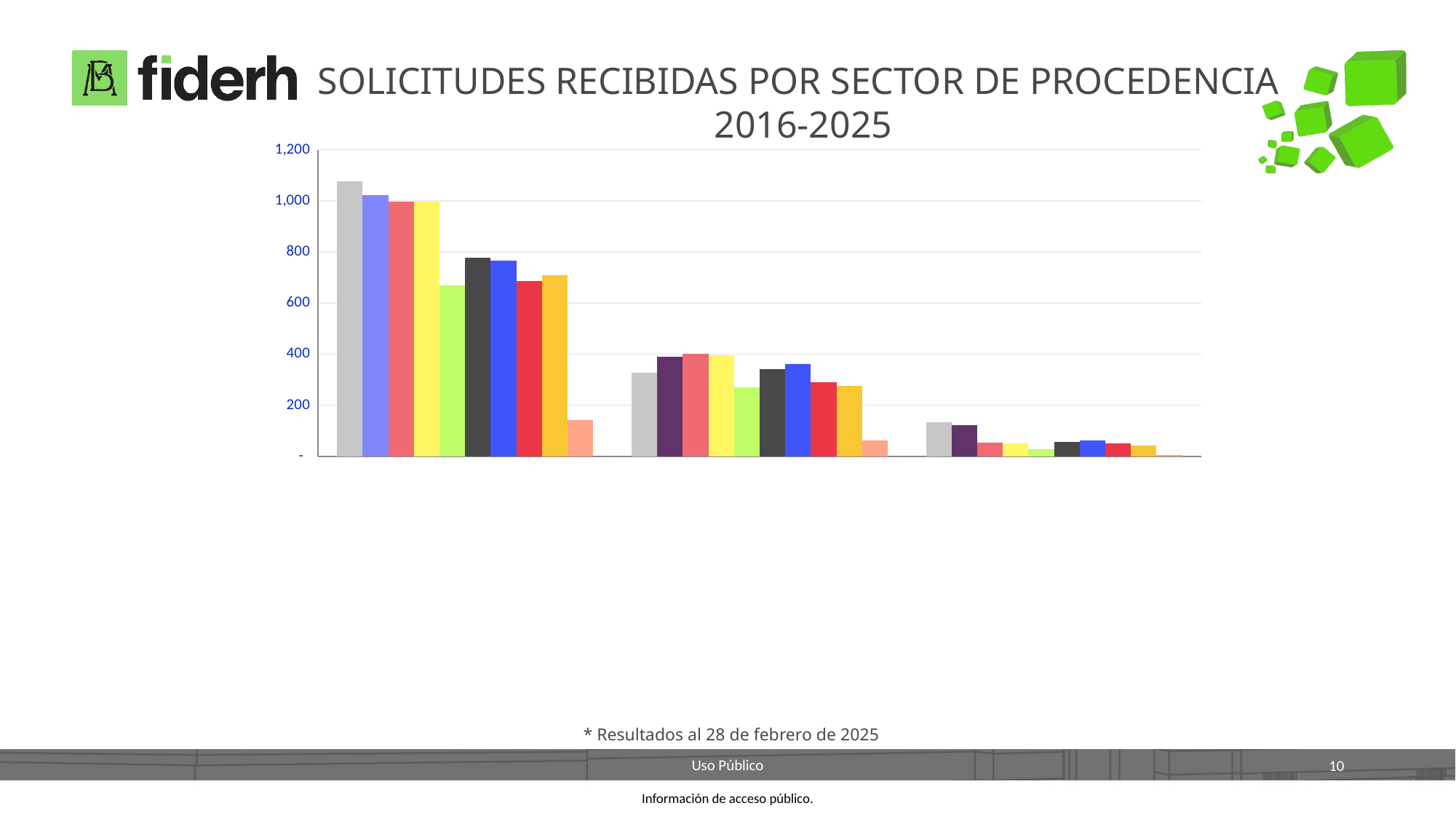
What kind of chart is shown on the slide? bar chart What is the title of the chart on the slide? SOLICITUDES RECIBIDAS POR SECTOR DE PROCEDENCIA 2016-2025 Is the value of the tallest bar in the leftmost group greater or less than 1,000? greater What is the highest value shown on the vertical axis of the chart? 1,200 How many bars are there in the first (leftmost) group of the chart? 10 Do the bar heights generally rise or fall moving from the leftmost group to the rightmost group? fall Which group of bars contains the tallest bar in the chart: the leftmost, middle, or rightmost? leftmost Is the value of the tallest bar in the rightmost group greater or less than 200? less How many groups of bars are plotted in the chart? 3 Is the value of the tallest bar in the middle group greater or less than 600? less Which group of bars has the lowest values overall: the leftmost, middle, or rightmost? rightmost